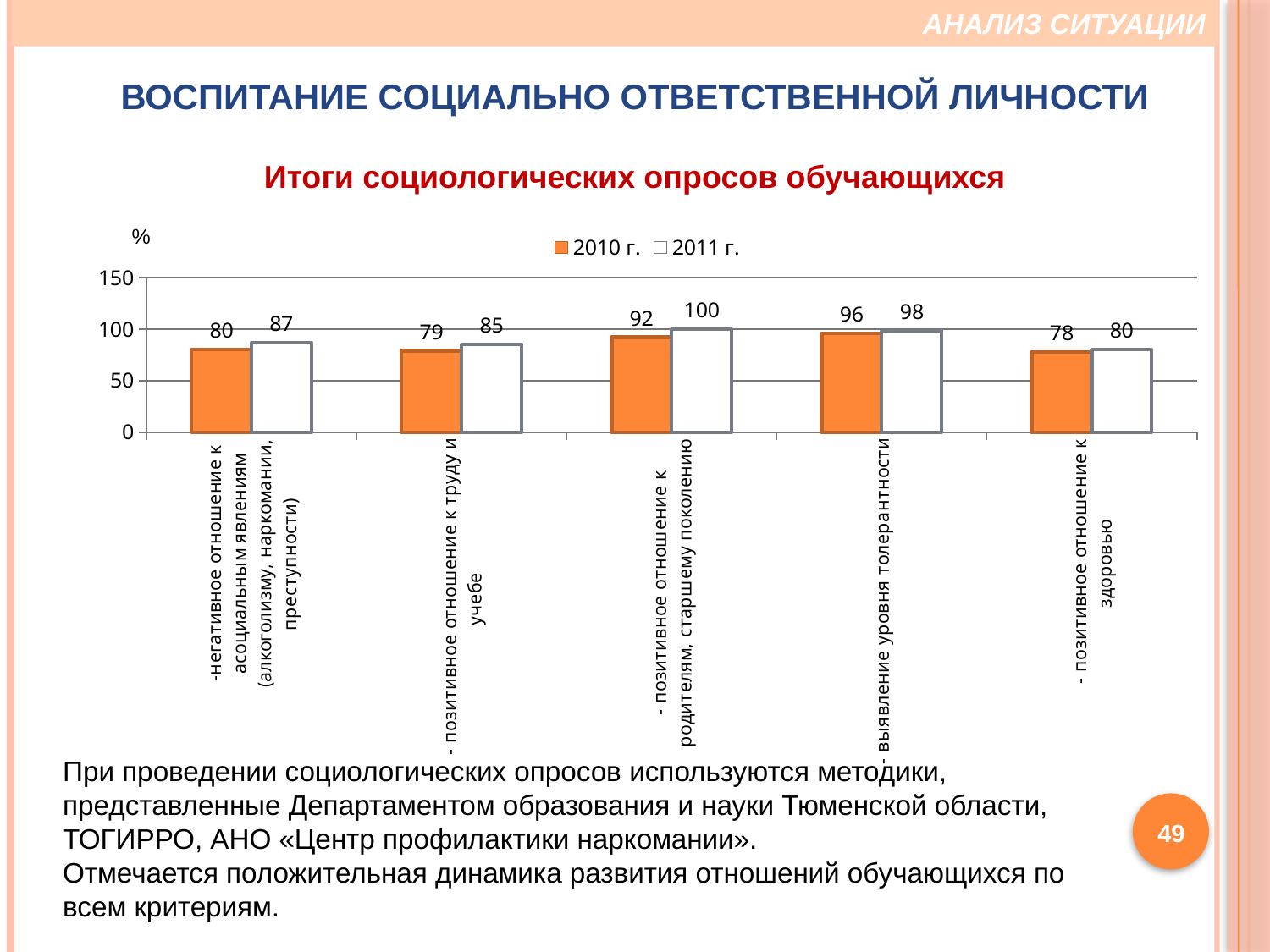
Which category has the highest 2011 г. value? позитивное отношение к родителям, старшему поколению What are the two legend entries of the chart? 2010 г. and 2011 г. Is the 2010 г. value for "выявление уровня толерантности" greater or less than 50? greater How many categories are shown on the x axis of the chart? 5 What is the 2011 г. value for "позитивное отношение к родителям, старшему поколению"? 100 What is the 2010 г. value for "позитивное отношение к труду и учебе"? 79 Which is larger for "позитивное отношение к здоровью": the 2010 г. value or the 2011 г. value? 2011 г. What type of chart is shown on the slide? bar chart Which category has the lowest 2010 г. value? позитивное отношение к здоровью How many series does the legend list? 2 What is the 2011 г. value for "выявление уровня толерантности"? 98 What is the difference between the 2011 г. and 2010 г. values for "негативное отношение к асоциальным явлениям"? 7